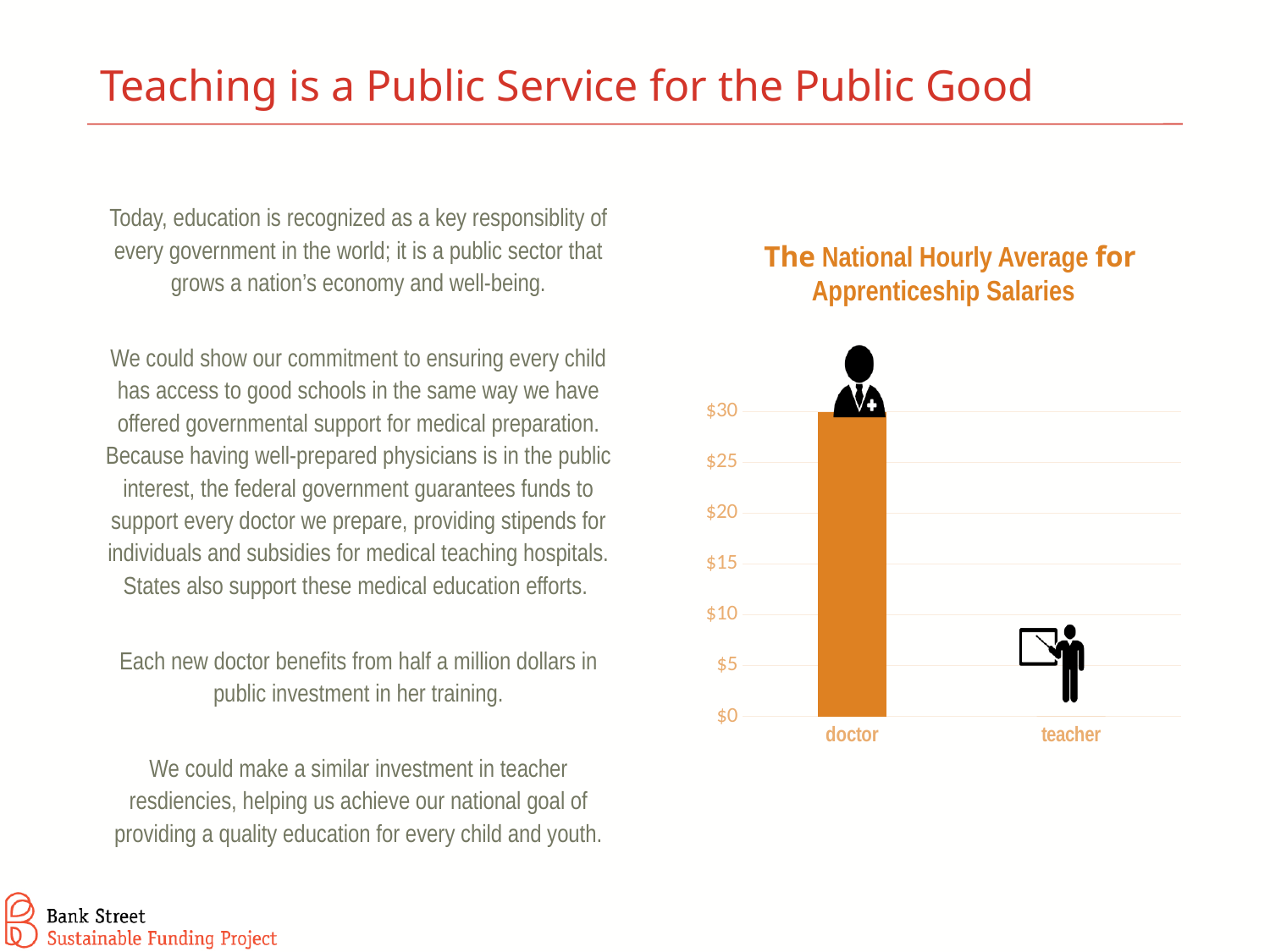
Which category has the lowest value in the chart? teacher Is the value for doctor greater or less than $20? greater Which is larger, the value for doctor or the value for teacher? doctor What is the title of the chart? The National Hourly Average for Apprenticeship Salaries What is the highest value labelled on the y axis of the chart? $30 Is the value for doctor greater or less than $25? greater Which category has the highest value in the chart? doctor What kind of chart is shown on the slide? bar chart How many categories are shown on the x axis of the chart? 2 What is the national hourly average apprenticeship salary for doctor according to the chart? $30